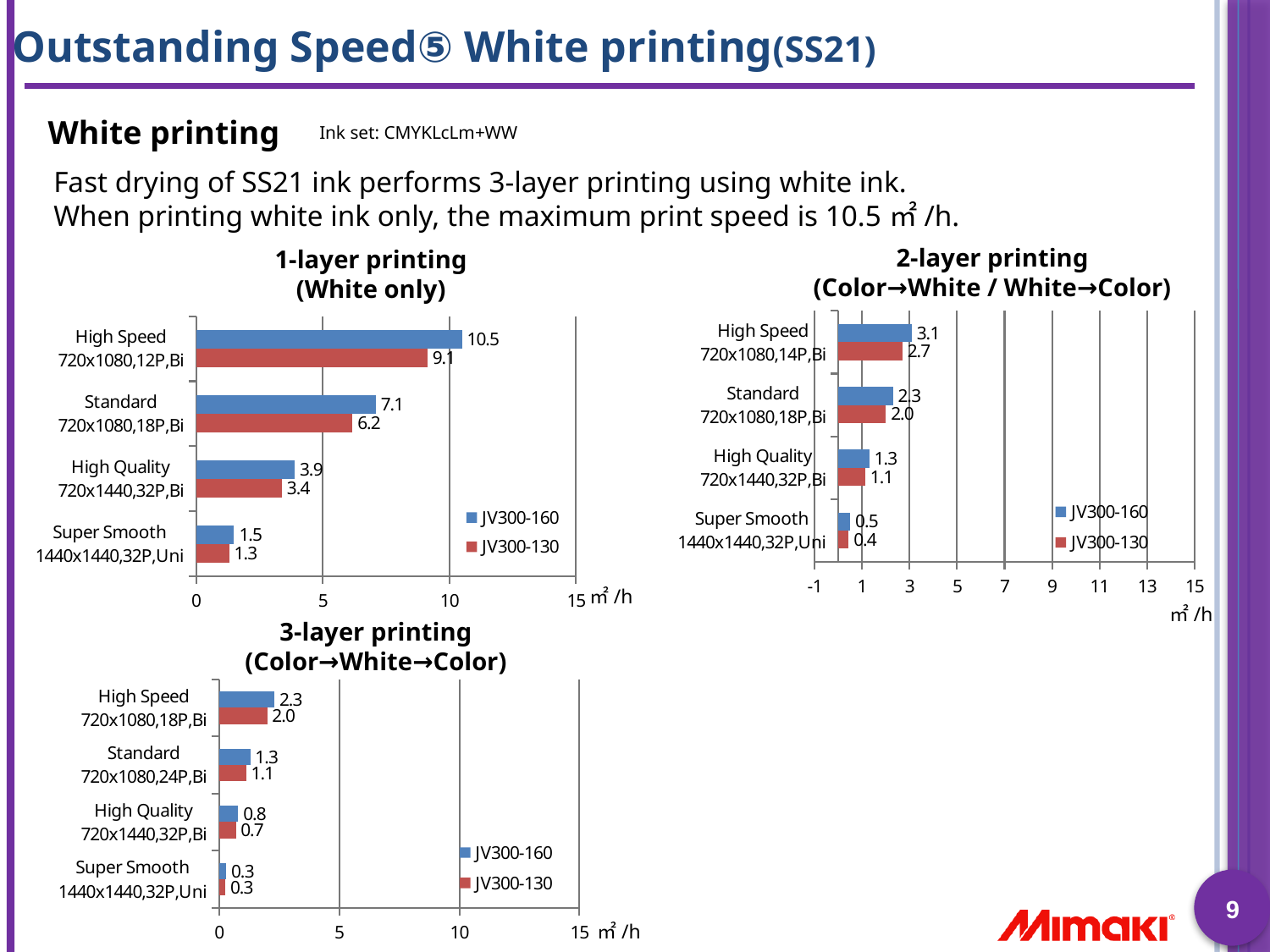
In the 3-layer printing chart, which is larger at Standard: JV300-160 or JV300-130? JV300-160 In the 1-layer printing (White only) chart, what is the value for JV300-160 at High Speed? 10.5 In the 1-layer printing (White only) chart, what is the value for JV300-130 at Standard? 6.2 In the 2-layer printing chart, what is the value for JV300-160 at High Quality? 1.3 In the 1-layer printing (White only) chart, what is the difference between JV300-160 and JV300-130 at High Speed? 1.4 In the 1-layer printing (White only) chart, which category has the lowest value for JV300-130? Super Smooth What kind of chart is the 1-layer printing (White only) chart? Bar chart How many series does the legend of the 2-layer printing chart list? 2 In the 3-layer printing chart, what is the value for JV300-130 at High Speed? 2.0 How many categories are shown in the 3-layer printing chart? 4 In the 2-layer printing chart, which category has the highest value for JV300-160? High Speed What unit is shown on the x axis of the 3-layer printing chart? ㎡/h